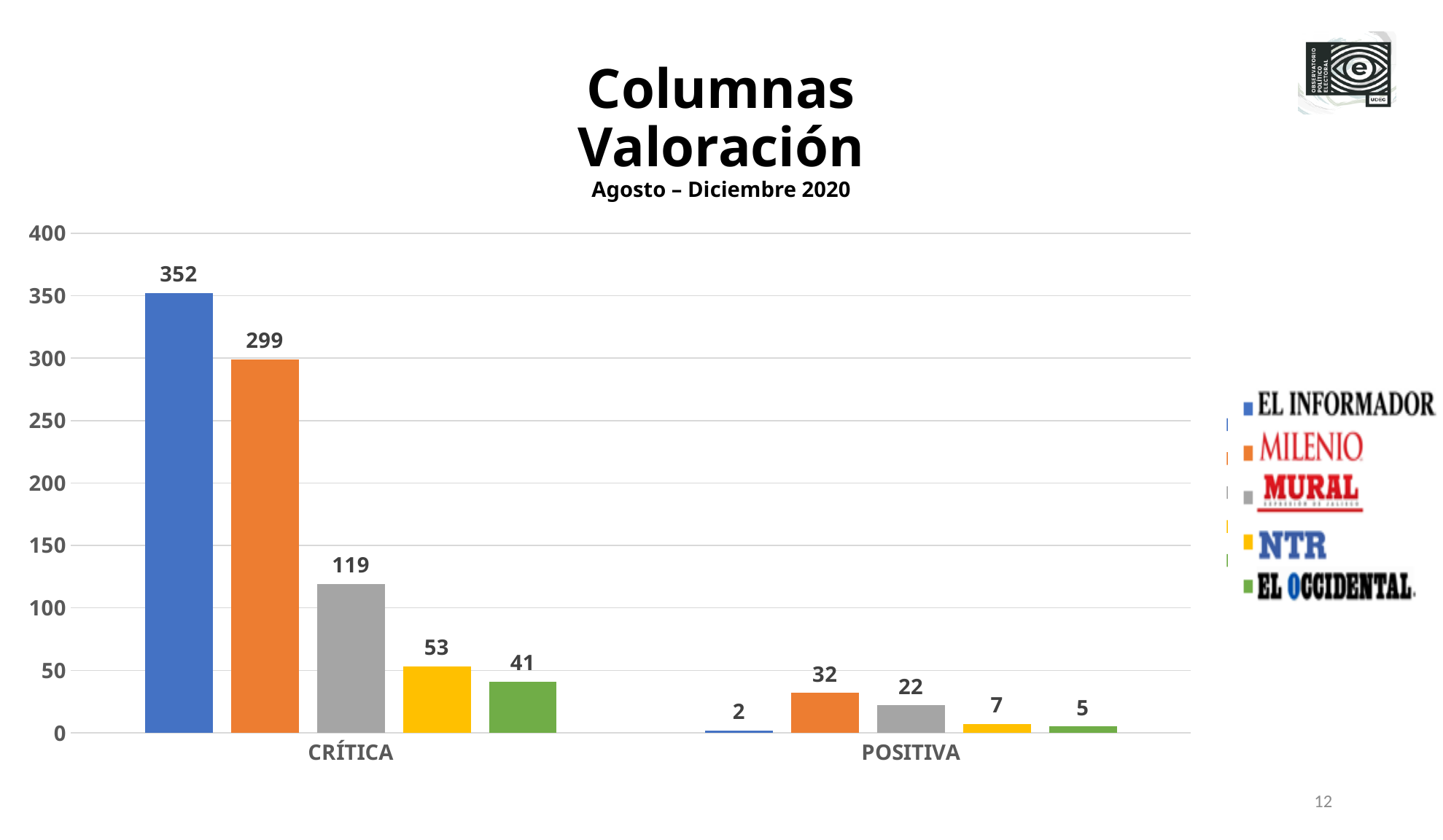
What is the difference between El Informador and Milenio in the CRÍTICA category? 53 What is the value for NTR in the CRÍTICA category? 53 What is the value for Milenio in the POSITIVA category? 32 What is the difference between Mural's CRÍTICA value and its POSITIVA value? 97 Which newspaper has the lowest value in the POSITIVA category? El Informador What is the value for El Informador in the CRÍTICA category? 352 How many categories are shown on the x axis? 2 How many series does the legend list? 5 Which is larger: Mural's CRÍTICA value or NTR's CRÍTICA value? Mural's CRÍTICA value Which newspaper has the highest value in the CRÍTICA category? El Informador What kind of chart is shown on the slide? Bar chart What period does the chart subtitle indicate? Agosto – Diciembre 2020